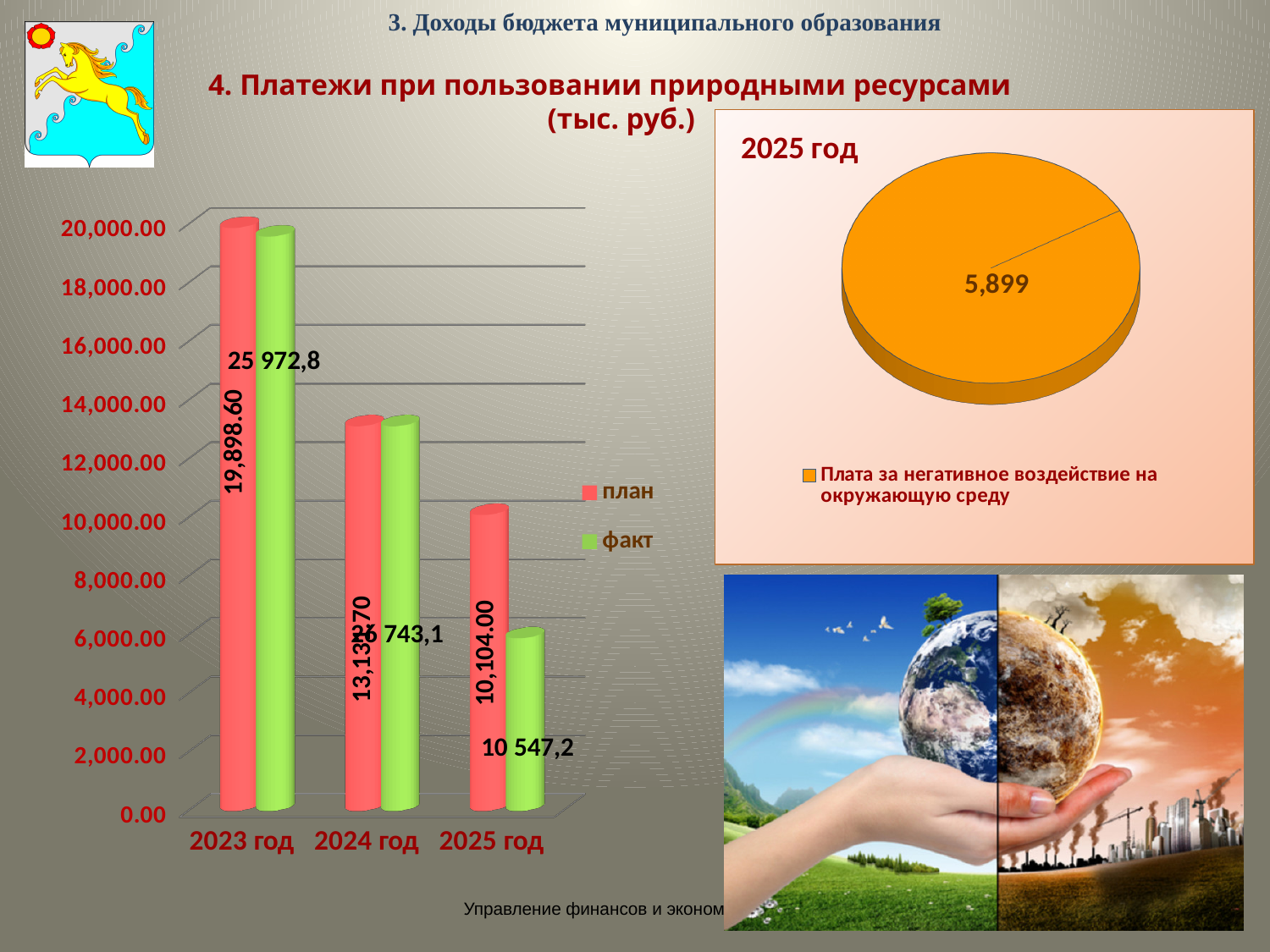
In the bar chart on the left, how many year categories are shown on the x axis? 3 In the bar chart on the left, what is the value of план for 2023 год? 19,898.60 In the bar chart on the left, which year has the highest план value? 2023 год In the bar chart on the left, how many series does the legend list? 2 In the bar chart on the left, is the факт value for 2025 год greater or less than 8,000.00? less In the bar chart on the left, which year has the lowest план value? 2025 год What kind of chart is the chart on the left of the slide? bar chart In the bar chart on the left, what is the value of план for 2025 год? 10,104.00 In the pie chart titled 2025 год, what value is shown on the slice? 5,899 In the bar chart on the left, what is the difference between план for 2023 год and план for 2025 год? 9,794.60 In the pie chart titled 2025 год, what is the legend entry for the slice? Плата за негативное воздействие на окружающую среду In the bar chart on the left, do the план values rise or fall from 2023 год to 2025 год? fall